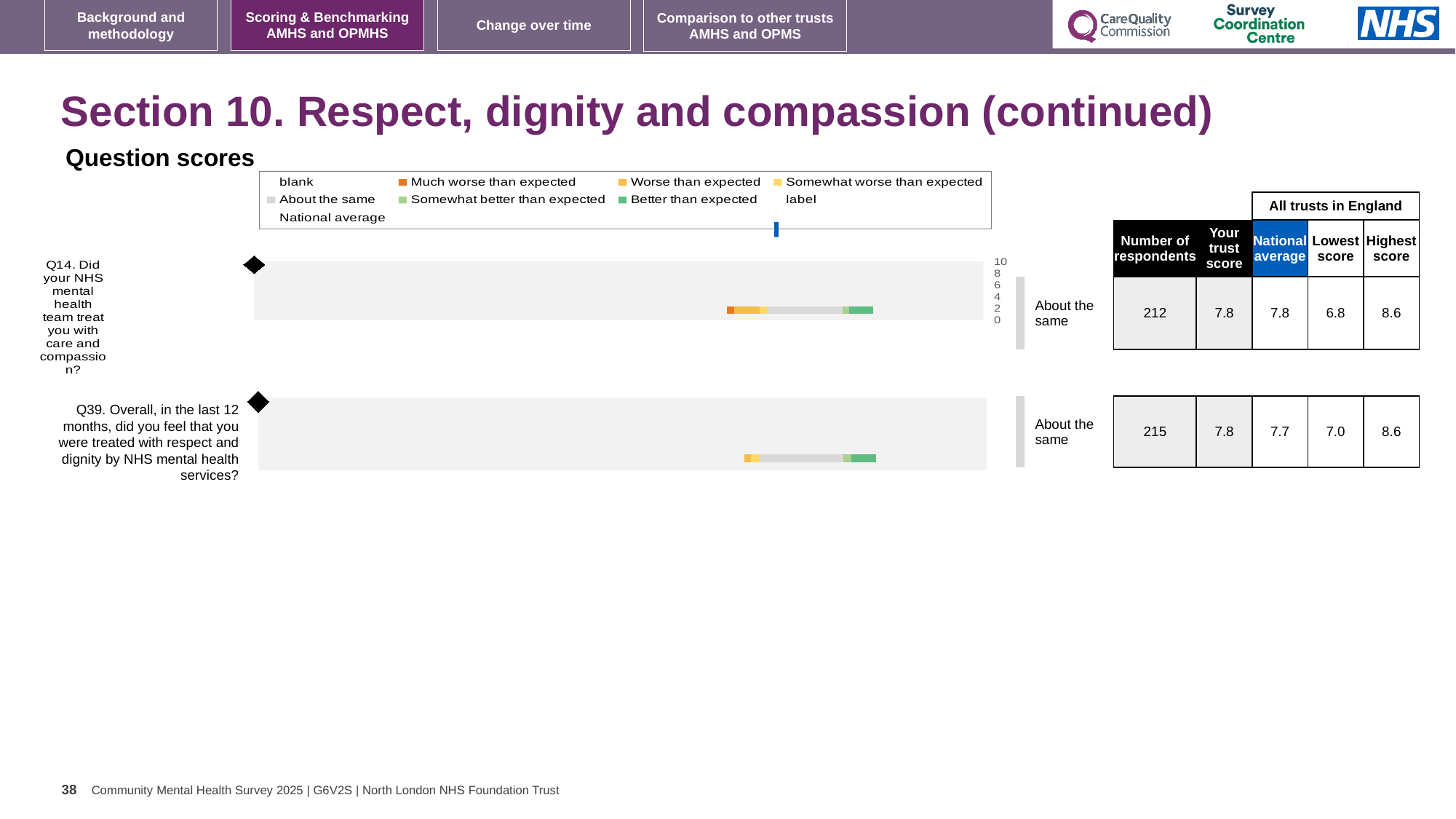
According to the table, how many respondents answered Q14? 212 What benchmark category label is shown next to the Q14 bar? About the same Which question has the higher lowest score across all trusts, Q14 or Q39? Q39 What is the trust score for Q14 shown in the table? 7.8 What kind of chart is used to show the question scores for Q14 and Q39? bar chart Which question had more respondents, Q14 or Q39? Q39 What is the difference between the highest score and the lowest score for Q14? 1.8 What colour represents 'Better than expected' in the chart legend? green How many questions (bars) are plotted on the slide? 2 According to the table, how many respondents answered Q39? 215 What is the national average for Q39 shown in the table? 7.7 What is the lowest score across all trusts in England for Q14? 6.8